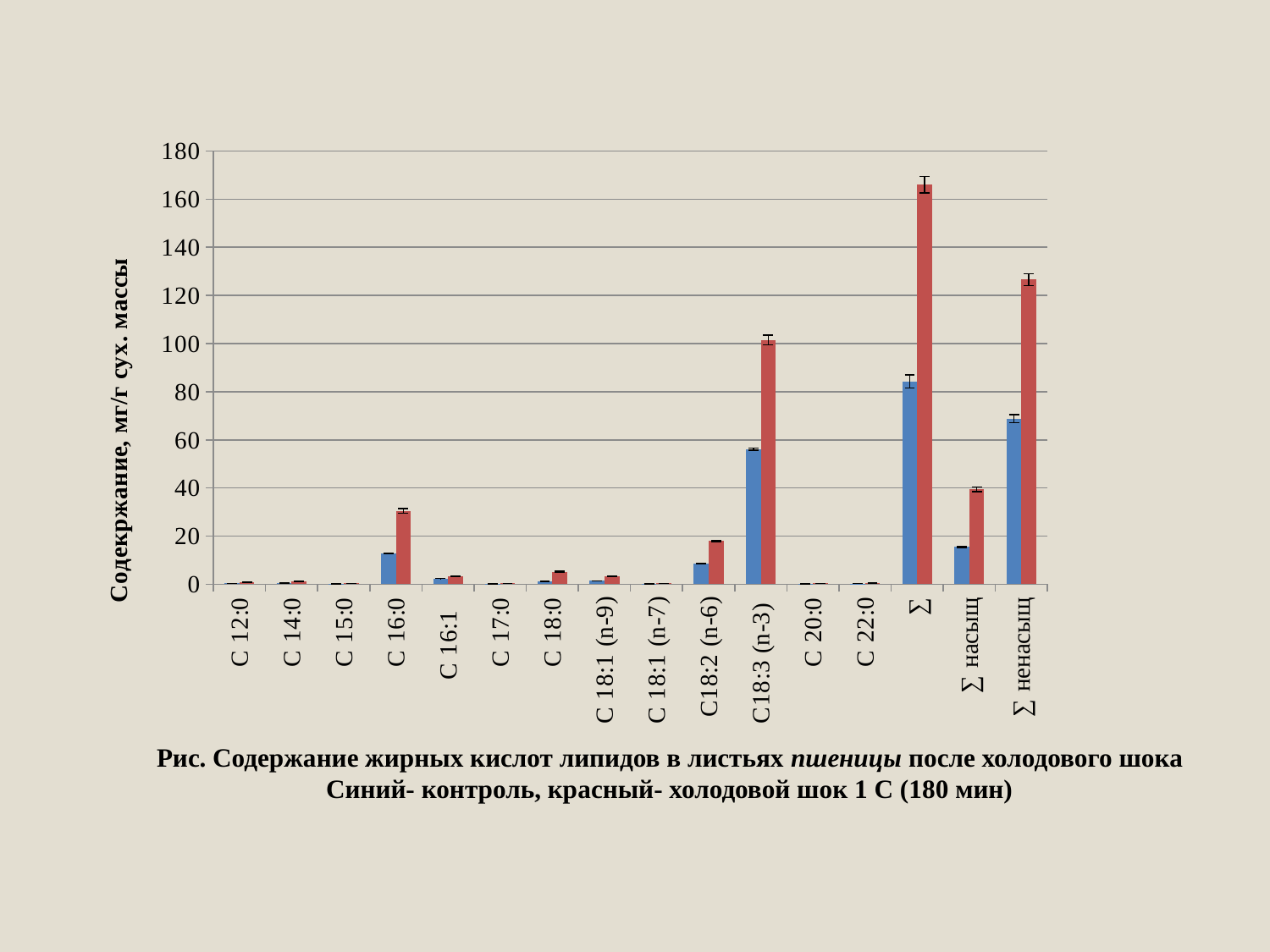
For C 16:0, which bar is taller, the blue one or the red one? red Is the red bar for Σ насыщ greater or less than 20? greater Which category has the tallest red bar? Σ Is the blue bar for Σ greater or less than 60? greater Is the red bar for C18:3 (n-3) greater or less than 80? greater What kind of chart is shown on the slide? bar chart Which blue bar is taller, Σ насыщ or Σ ненасыщ? Σ ненасыщ According to the caption, what do the blue bars represent? контроль How many categories are shown along the x axis of the chart? 16